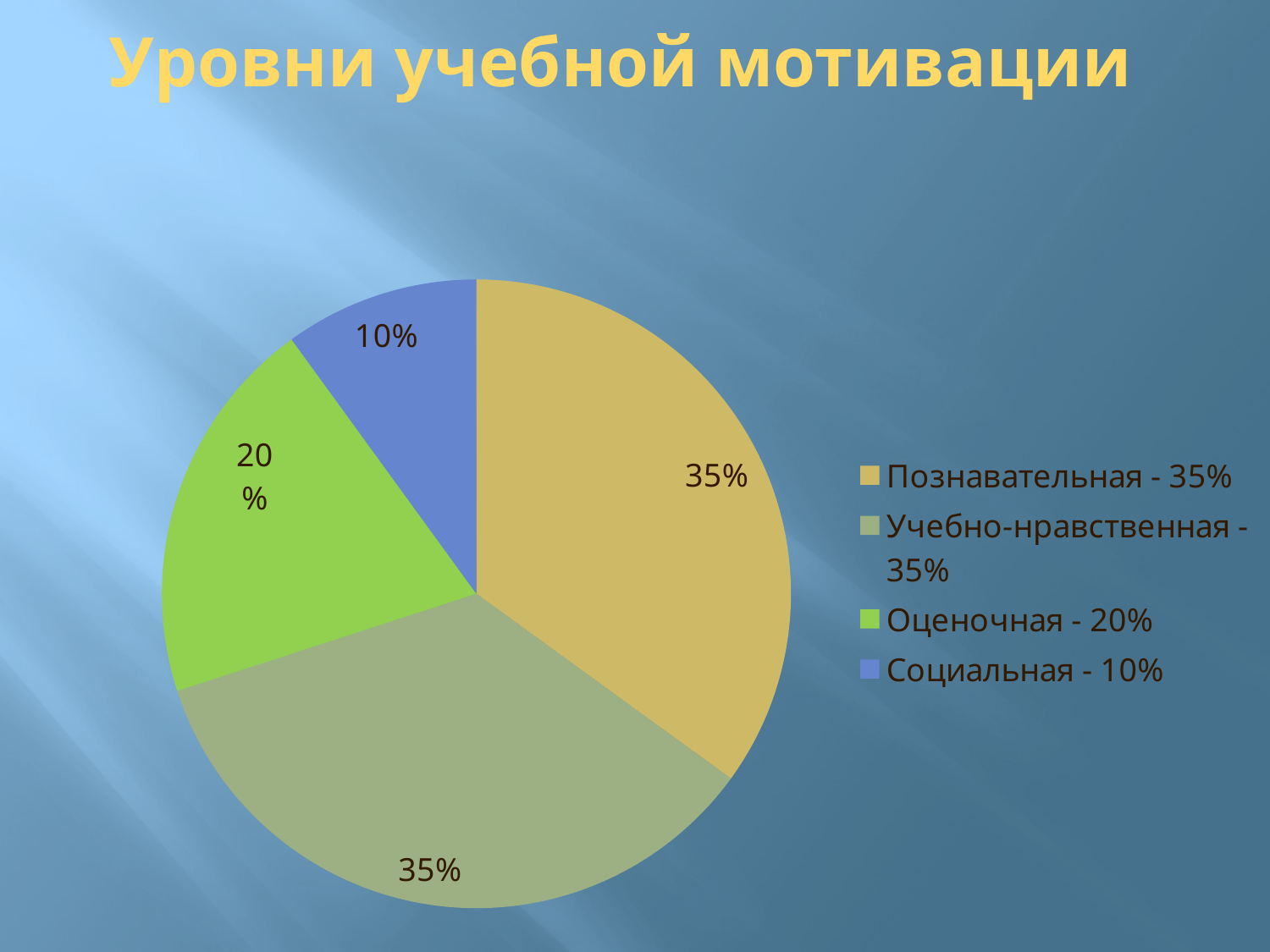
What is the difference between the shares of Оценочная and Социальная? 10% What is the difference between the shares of Познавательная and Оценочная? 15% What colour is the slice for Социальная? blue What is the share for Оценочная? 20% What is the share for Познавательная? 35% What is the share for Учебно-нравственная? 35% How many slices does the pie chart have? 4 What is the share for Социальная? 10% Which category has the smallest slice of the pie? Социальная What type of chart is shown on the slide? pie chart Which is larger, the share for Оценочная or the share for Социальная? Оценочная What is the title of the chart? Уровни учебной мотивации